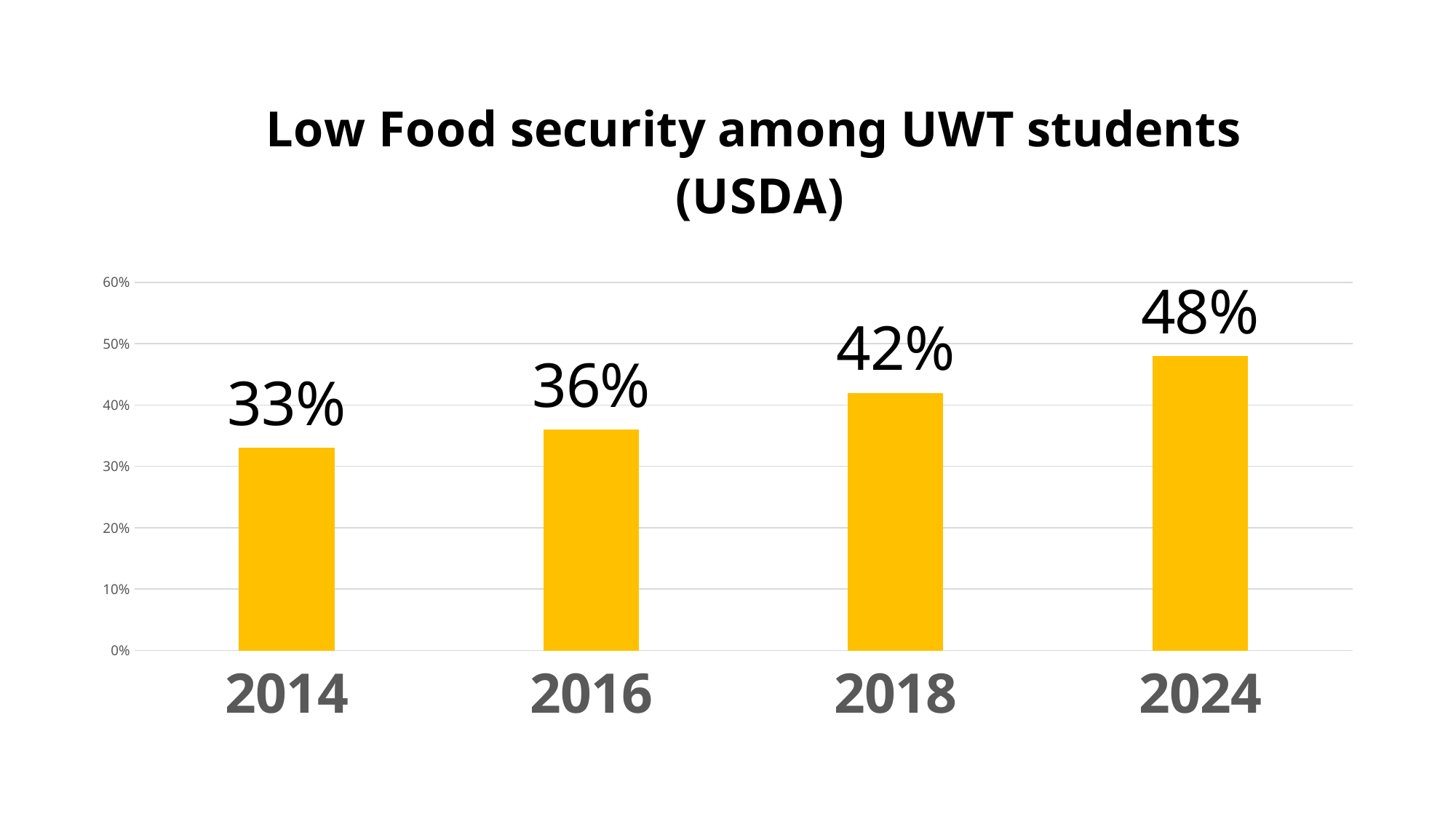
How many years are shown on the chart? 4 What kind of chart is shown on the slide? Bar chart What is the value for 2014? 33% Which is larger, the value for 2016 or the value for 2018? 2018 Which year has the lowest value? 2014 What is the difference between the values for 2024 and 2014? 15% Which year has the highest value? 2024 What is the difference between the values for 2018 and 2016? 6% What is the value for 2018? 42% Is the value for 2024 greater or less than 40%? greater What is the value for 2024? 48% Do the values rise or fall from 2014 to 2024? Rise